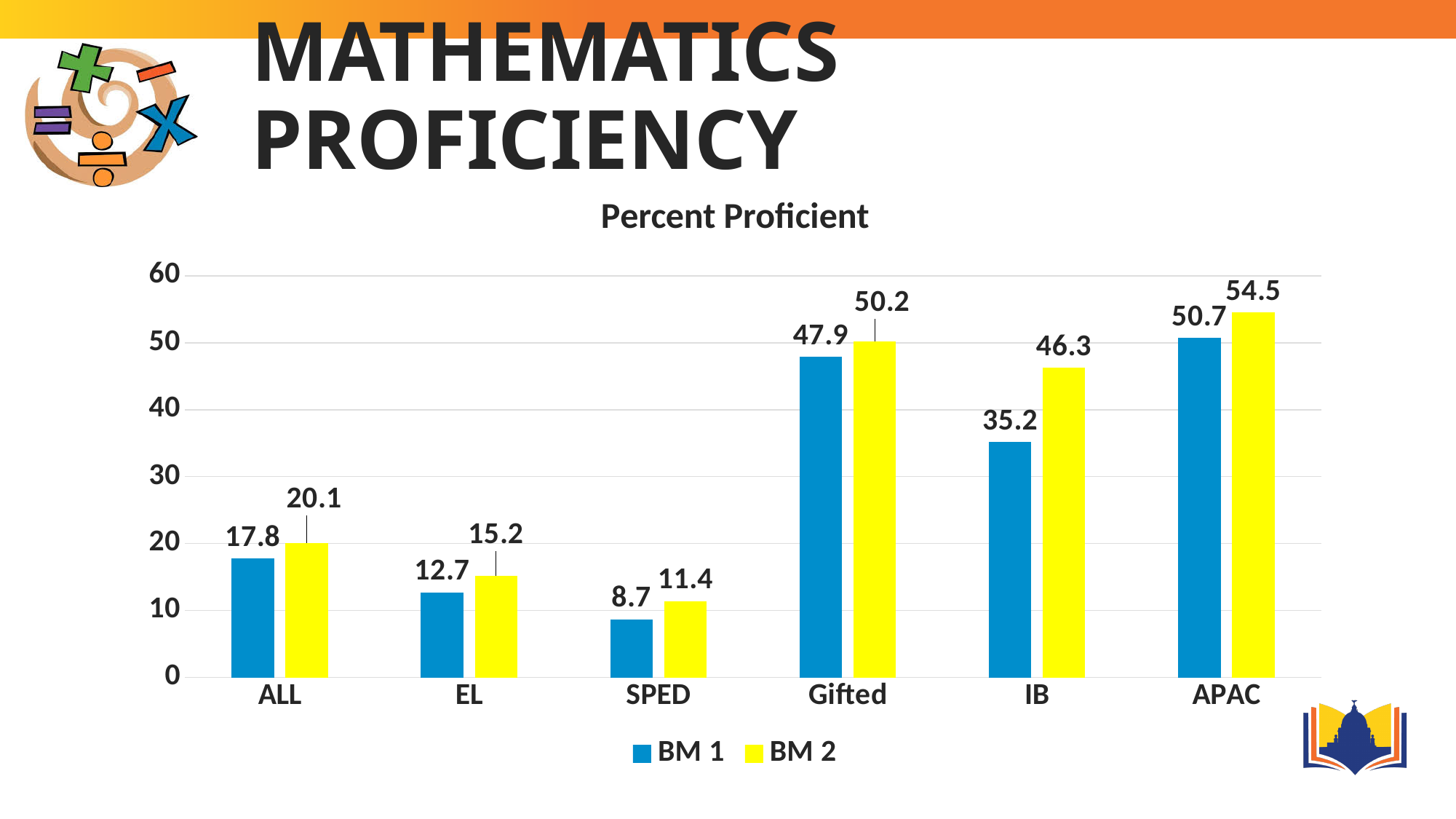
What is the BM 1 value for IB? 35.2 What is the BM 2 value for EL? 15.2 How many categories are shown on the x axis? 6 Which category has the highest BM 2 value? APAC Which category has the lowest BM 1 value? SPED Is the BM 2 value for Gifted greater or less than 40? greater What is the difference between the BM 2 and BM 1 values for IB? 11.1 Which is larger for ALL, the BM 1 value or the BM 2 value? BM 2 How many series does the legend list? 2 What is the title of the chart? Percent Proficient What is the BM 1 value for Gifted? 47.9 What kind of chart is shown on the slide? Bar chart